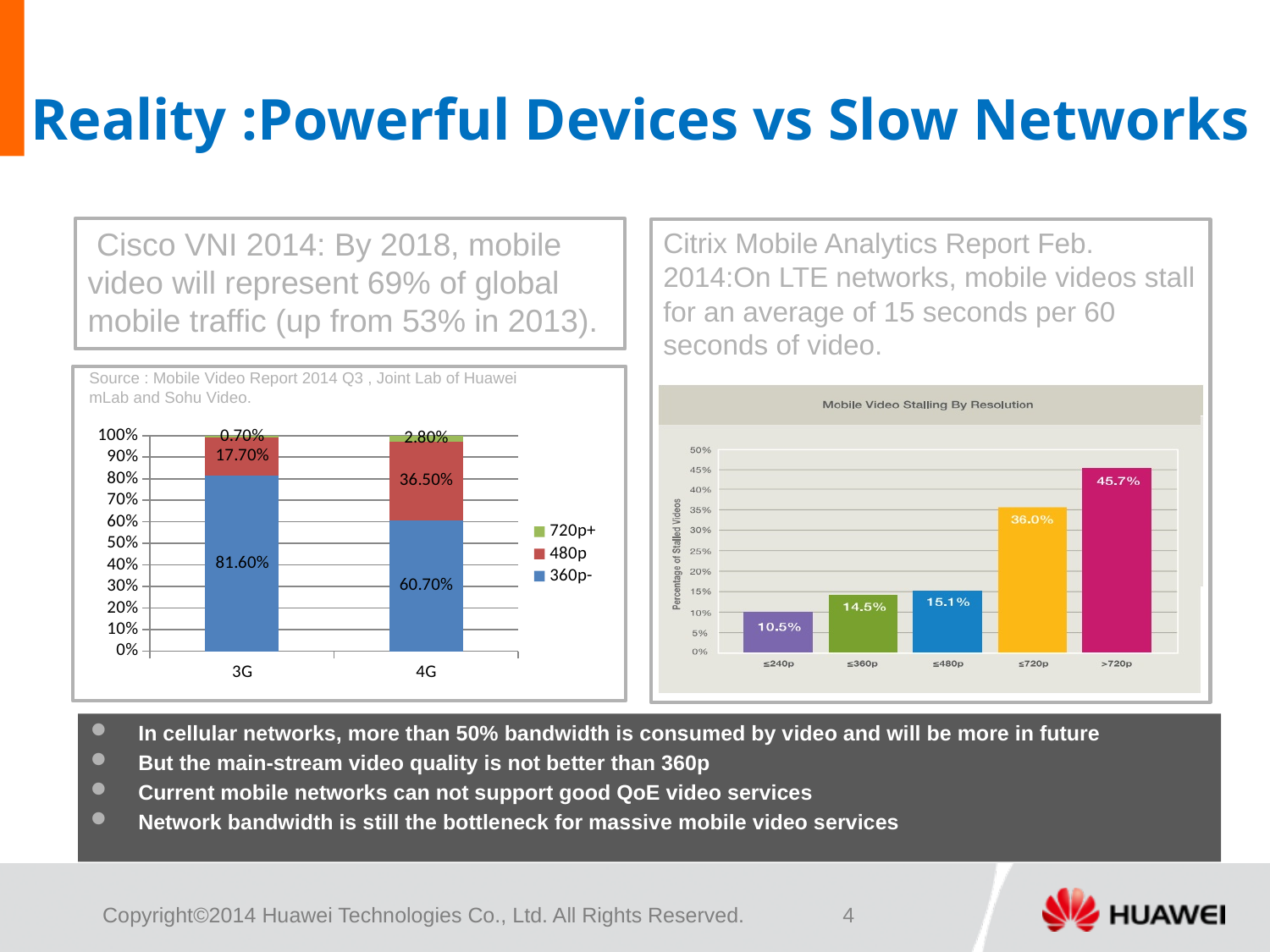
In the left stacked bar chart, what is the difference between the 480p shares of 4G and 3G? 18.80% In the chart titled 'Mobile Video Stalling By Resolution', what is the percentage of stalled videos for ≤240p? 10.5% In the left stacked bar chart, what is the 360p- share for 3G? 81.60% In the chart titled 'Mobile Video Stalling By Resolution', how many resolution categories are shown? 5 In the chart titled 'Mobile Video Stalling By Resolution', which resolution has the highest percentage of stalled videos? >720p In the left stacked bar chart, what is the 480p share for 4G? 36.50% In the left stacked bar chart, what is the 720p+ share for 3G? 0.70% In the left stacked bar chart, how many series does the legend list? 3 In the chart titled 'Mobile Video Stalling By Resolution', which resolution has the lowest percentage of stalled videos? ≤240p In the left stacked bar chart, which network has the larger 360p- share, 3G or 4G? 3G In the chart titled 'Mobile Video Stalling By Resolution', what is the difference between the values for >720p and ≤720p? 9.7% In the chart titled 'Mobile Video Stalling By Resolution', do the values rise or fall as resolution increases along the x axis? rise